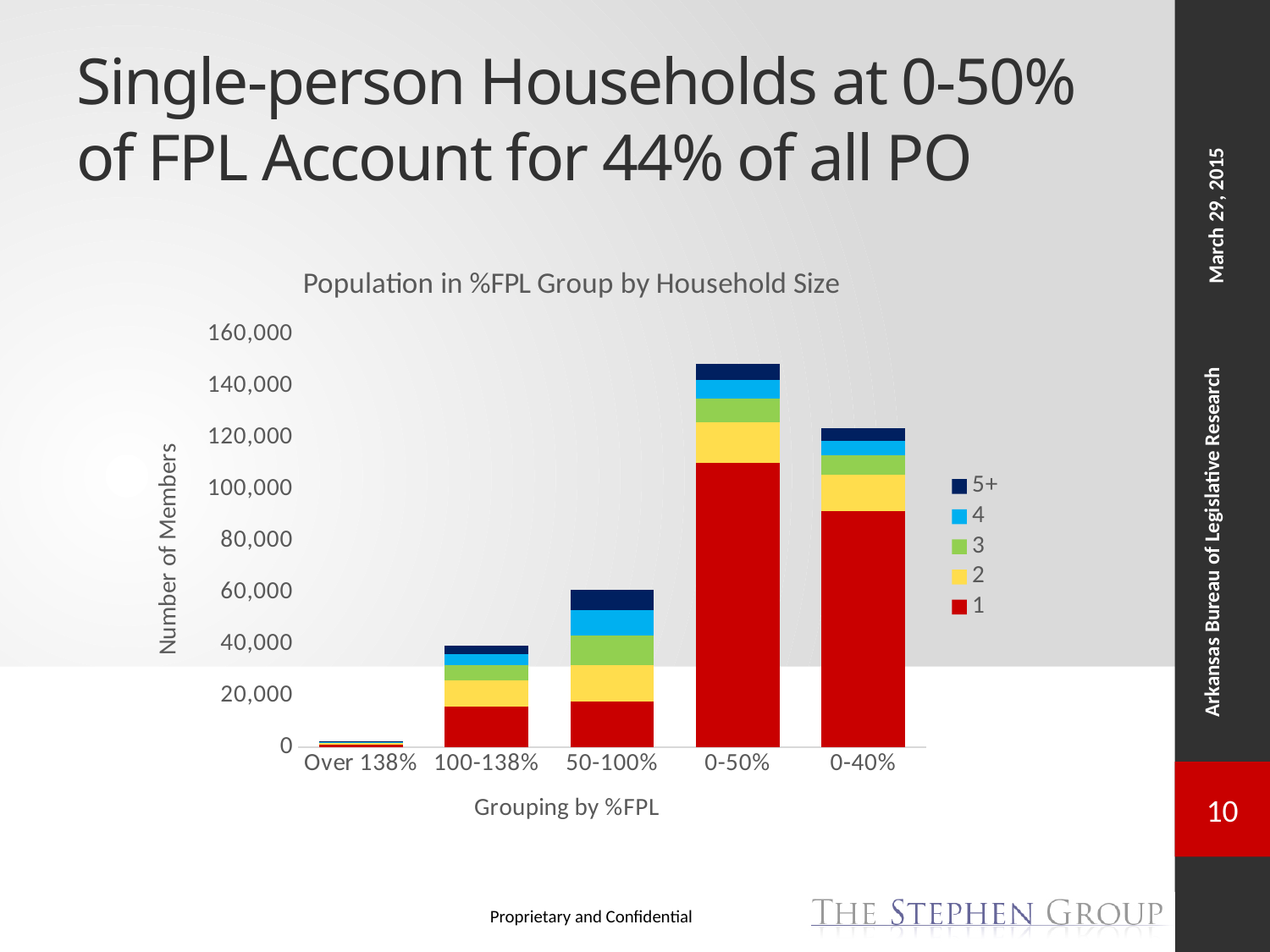
Is the total stacked bar for the 0-50% group greater or less than 140,000? greater Which has the larger total stacked bar, the 100-138% group or the 50-100% group? 50-100% How many series does the legend list? 5 Is the total stacked bar for the 50-100% group greater or less than 40,000? greater Is the total stacked bar for the Over 138% group greater or less than 20,000? less Which has the larger total stacked bar, the 0-50% group or the 0-40% group? 0-50% Which %FPL group has the tallest stacked bar? 0-50% What is the title of the chart? Population in %FPL Group by Household Size How many %FPL groups are shown on the x axis? 5 Which %FPL group has the shortest stacked bar? Over 138% What kind of chart is shown on the slide? stacked bar chart